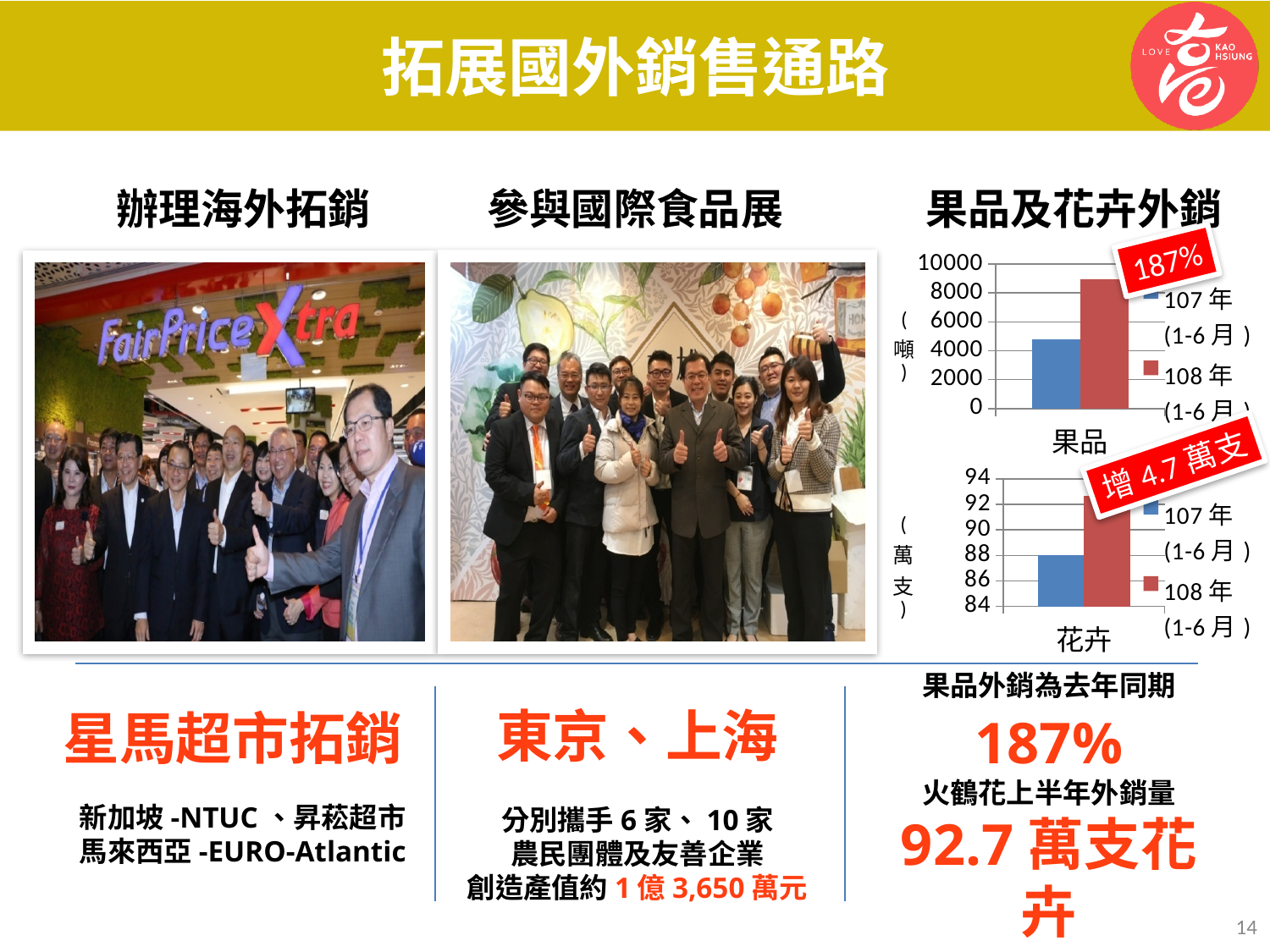
In the 花卉 chart, which series has the taller bar, 107年(1-6月) or 108年(1-6月)? 108年(1-6月) In the 花卉 chart, is the value for 108年(1-6月) greater or less than 90? greater How many series does the legend of the 花卉 chart list? 2 What percentage is shown in the callout on the 果品 chart? 187% In the 果品 chart, is the value for 107年(1-6月) greater or less than 6000? less In the 果品 chart, is the value for 108年(1-6月) greater or less than 8000? greater What does the callout on the 花卉 chart say? 增 4.7 萬支 What kind of chart is the 果品 chart? bar chart How many series does the legend of the 果品 chart list? 2 In the 果品 chart, which series has the taller bar, 107年(1-6月) or 108年(1-6月)? 108年(1-6月) What is the unit shown on the y axis of the 花卉 chart? 萬支